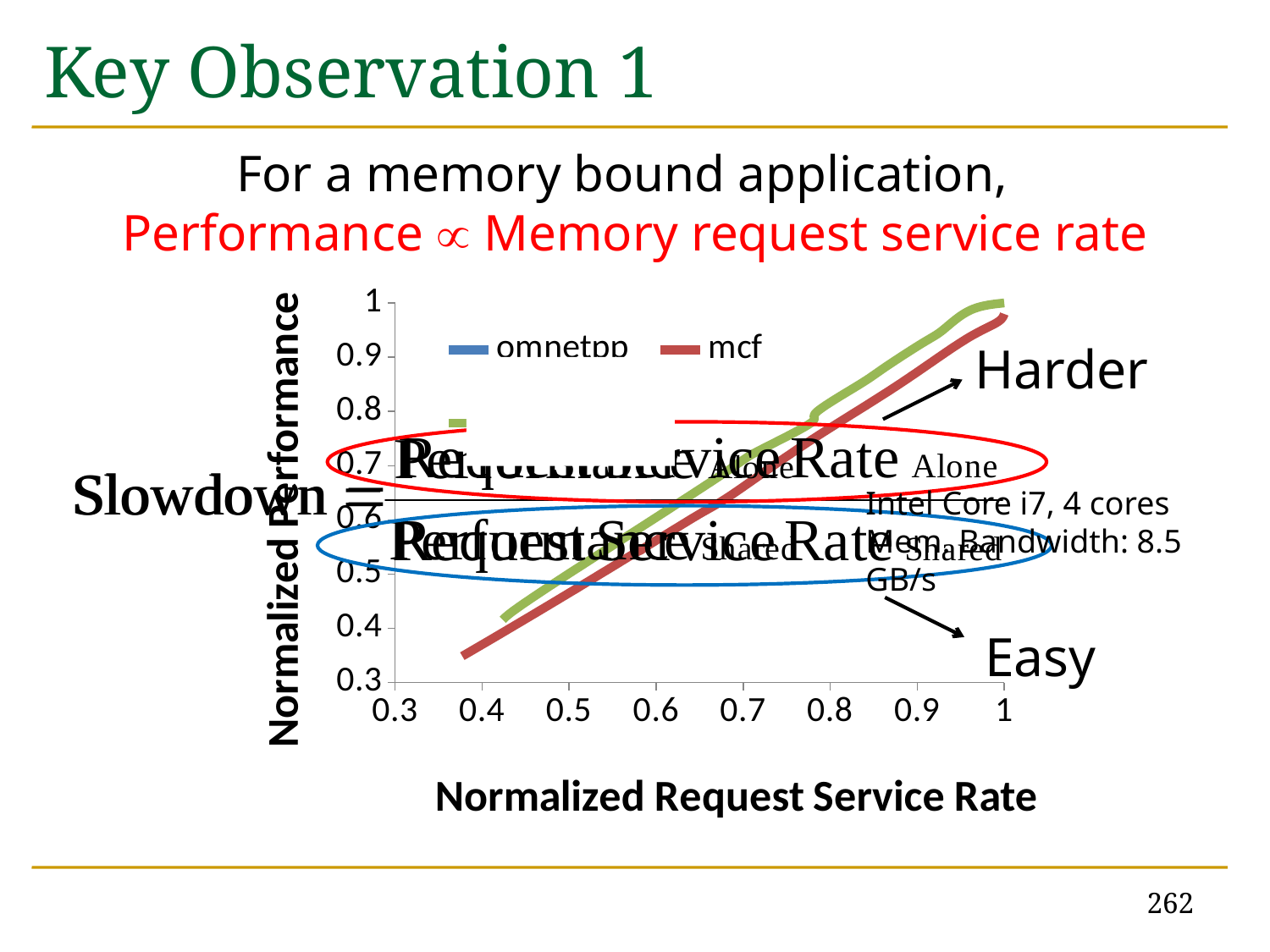
What kind of chart is shown on the slide? line chart Does the normalized performance of mcf rise or fall as the normalized request service rate increases? rise Does the normalized performance of omnetpp rise or fall as the normalized request service rate increases? rise What is the title of the chart's x axis? Normalized Request Service Rate Is the normalized performance of mcf at a normalized request service rate of 1 greater or less than 0.9? greater Which two series are listed in the chart's legend? omnetpp and mcf At a normalized request service rate of 0.7, which series has the higher normalized performance, omnetpp or mcf? omnetpp What is the lowest value shown on the chart's y axis? 0.3 Is the normalized performance of omnetpp at a normalized request service rate of 1 greater or less than 0.9? greater